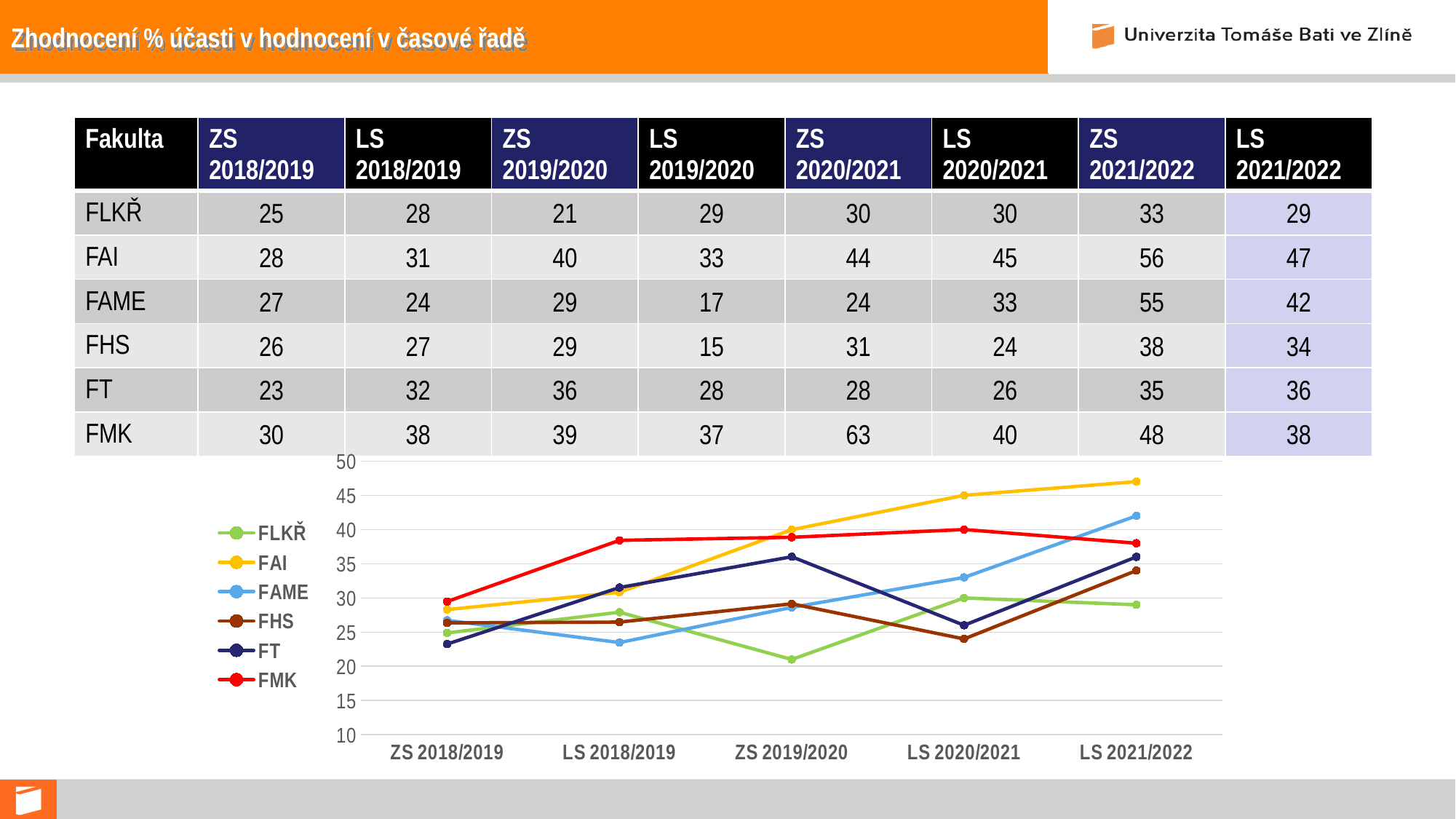
Is the value for FT at ZS 2018/2019 greater or less than 25? less How many series does the chart's legend list? 6 Which series has the highest value at LS 2021/2022 in the chart? FAI What is the value of FAI at LS 2020/2021 in the chart? 45 What kind of chart is shown below the table? line chart Is the value for FAME at LS 2021/2022 greater or less than 40? greater Which series has the lowest value at LS 2018/2019 in the chart? FAME What is the value of FMK at LS 2020/2021 in the chart? 40 At LS 2018/2019, which is larger in the chart: FMK or FAI? FMK What is the value of FLKŘ at LS 2020/2021 in the chart? 30 How many points are there along the x axis of the chart? 5 Which series has the lowest value at ZS 2019/2020 in the chart? FLKŘ